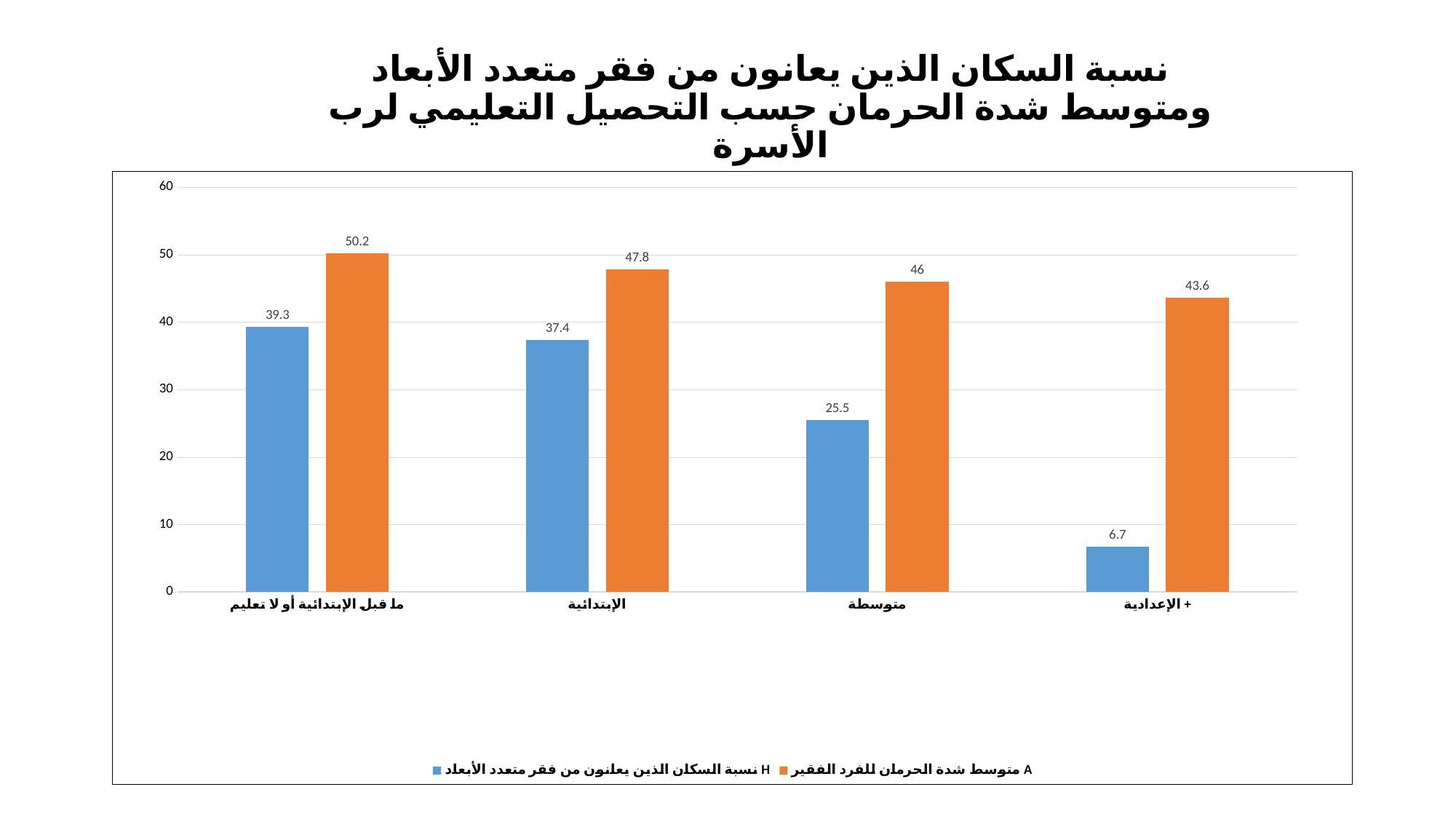
Which category has the highest value in the H series (نسبة السكان الذين يعانون من فقر متعدد الأبعاد)? ما قبل الإبتدائية أو لا تعليم Do the values of the H series (نسبة السكان الذين يعانون من فقر متعدد الأبعاد) rise or fall from "ما قبل الإبتدائية أو لا تعليم" to "الإعدادية +"? Fall What kind of chart is shown on the slide? Bar chart Which category has the lowest value in the A series (متوسط شدة الحرمان للفرد الفقير)? الإعدادية + What is the value of the A series (متوسط شدة الحرمان للفرد الفقير) for the category "الإبتدائية"? 47.8 What is the value of the A series (متوسط شدة الحرمان للفرد الفقير) for the category "متوسطة"? 46 How many categories are shown on the x axis? 4 How many series does the legend list? 2 What is the value of the H series (نسبة السكان الذين يعانون من فقر متعدد الأبعاد) for the category "الإعدادية +"? 6.7 What is the value of the H series (نسبة السكان الذين يعانون من فقر متعدد الأبعاد) for the category "ما قبل الإبتدائية أو لا تعليم"? 39.3 What is the difference between the A series value and the H series value for the category "الإعدادية +"? 36.9 For the category "الإبتدائية", which series has the larger value, H or A? A (متوسط شدة الحرمان للفرد الفقير)